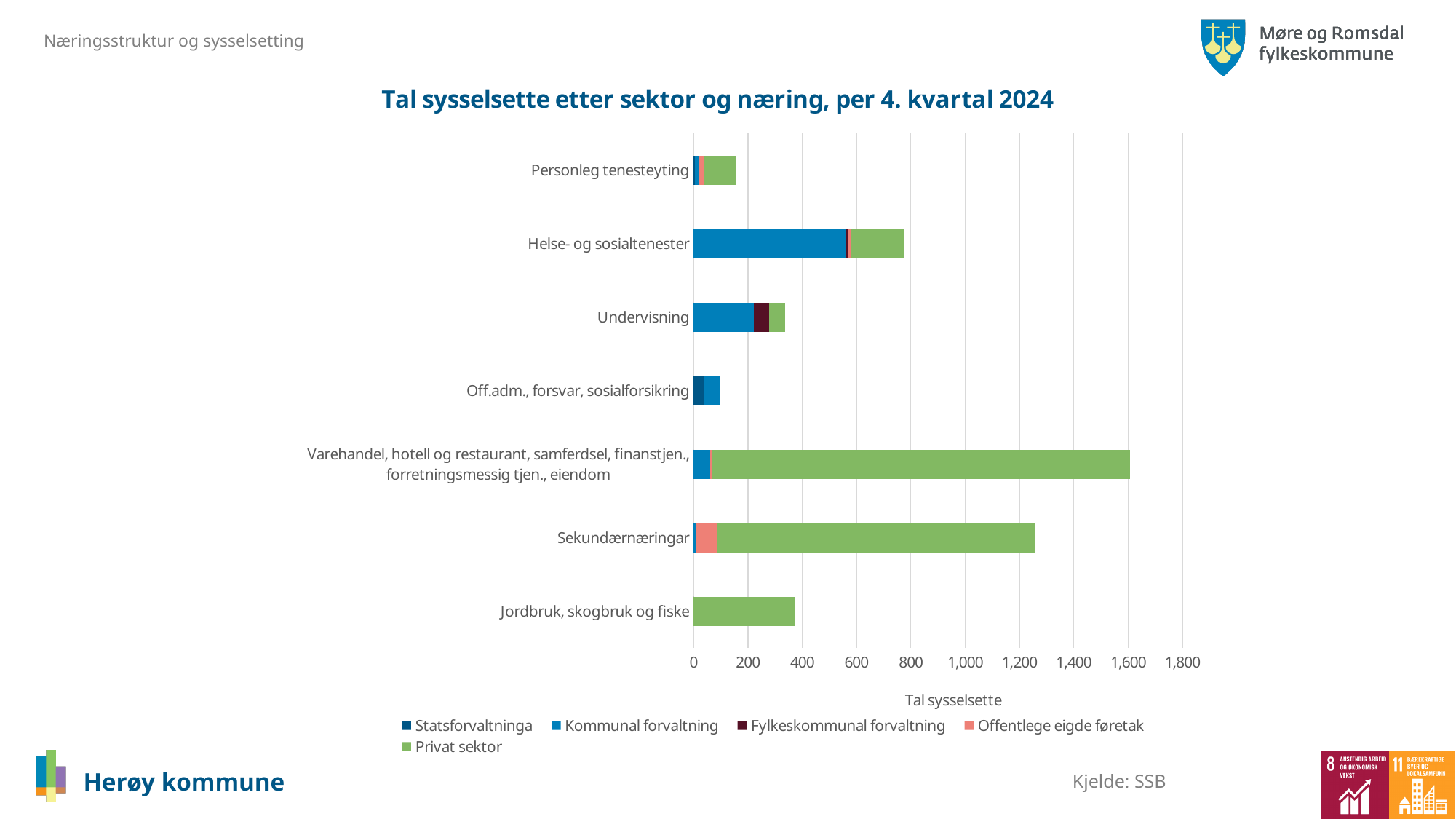
Is the total value for Off.adm., forsvar, sosialforsikring greater or less than 200? less Is the total value for Varehandel, hotell og restaurant, samferdsel, finanstjen., forretningsmessig tjen., eiendom greater or less than 1,400? greater What is the title of the chart? Tal sysselsette etter sektor og næring, per 4. kvartal 2024 What colour represents Privat sektor in the chart? Green Which has the larger total: Sekundærnæringar or Helse- og sosialtenester? Sekundærnæringar Is the total value for Jordbruk, skogbruk og fiske greater or less than 200? greater What kind of chart is shown on the slide? Stacked bar chart How many series does the legend list? 5 How many industry categories are shown on the y axis of the chart? 7 Which category has the highest total number of employees? Varehandel, hotell og restaurant, samferdsel, finanstjen., forretningsmessig tjen., eiendom